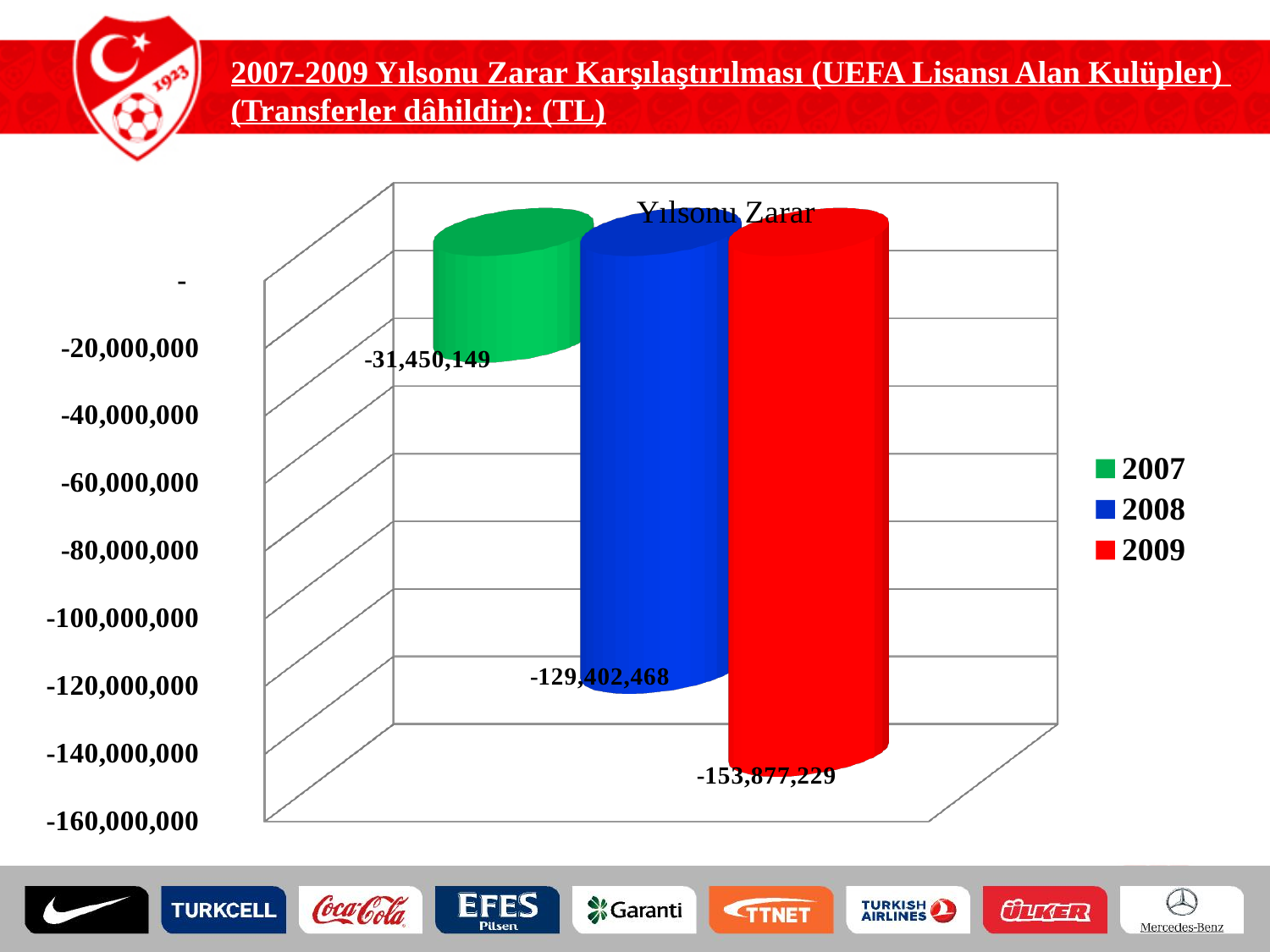
Which year shows the largest year-end loss in the chart? 2009 By how much does the loss for 2009 exceed the loss for 2008? 24,474,761 What kind of chart is shown on the slide? bar chart Is the value for 2008 greater or less than -100,000,000? less Which year shows the smallest year-end loss in the chart? 2007 What is the value for 2009 in the Yılsonu Zarar chart? -153,877,229 How many series does the legend list? 3 By how much does the loss for 2008 exceed the loss for 2007? 97,952,319 What colour represents 2009 in the chart? red Which year has the larger loss, 2007 or 2008? 2008 What is the value for 2007 in the Yılsonu Zarar chart? -31,450,149 What is the value for 2008 in the Yılsonu Zarar chart? -129,402,468